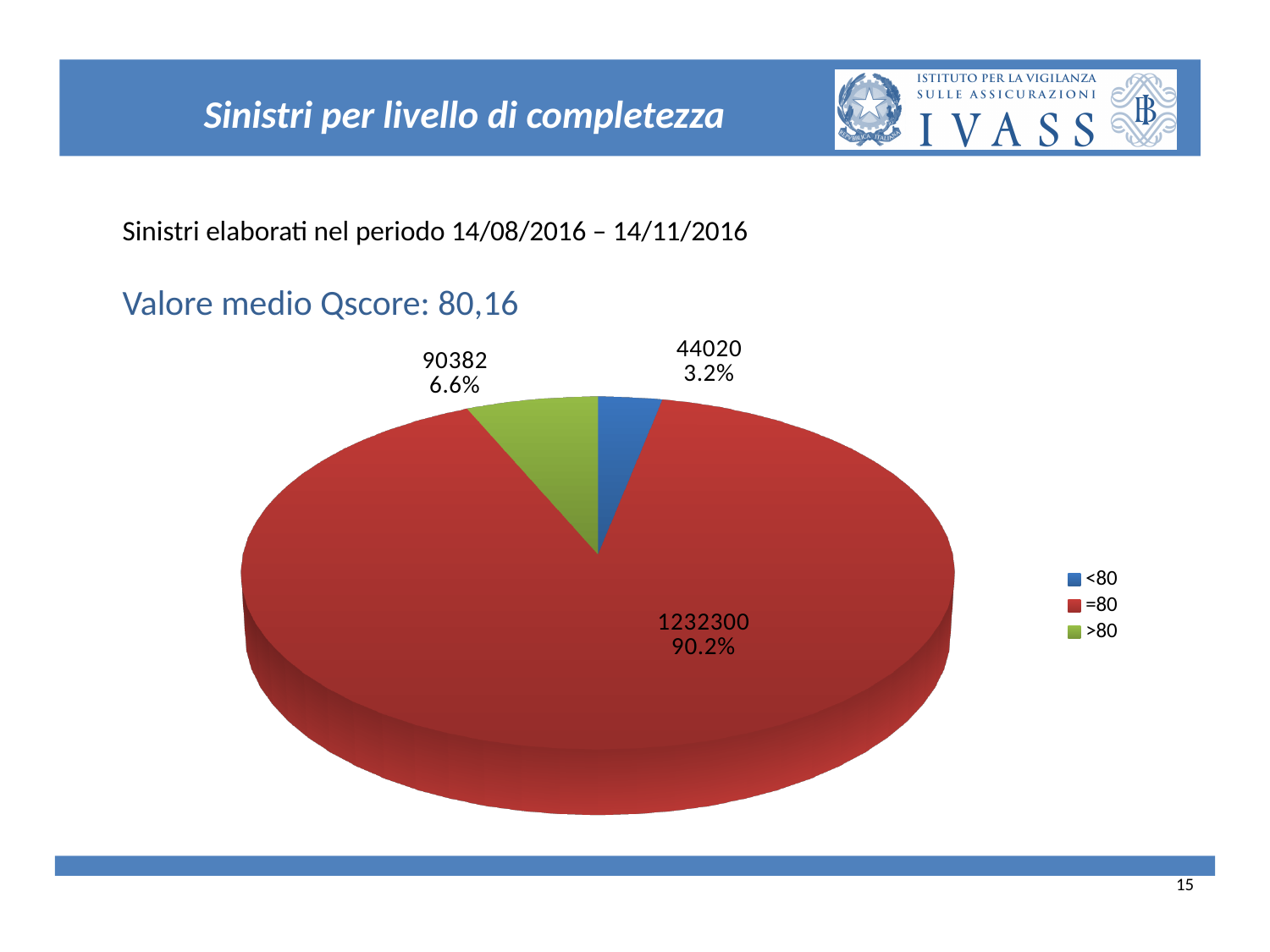
What kind of chart is shown on the slide? pie chart How many slices does the pie chart have? 3 What share of the pie does the =80 slice represent? 90.2% Which colour represents the =80 category in the legend? red What share of the pie does the >80 slice represent? 6.6% Which category has the largest slice? =80 What is the value for the <80 slice? 44020 Which category has the smallest slice? <80 What share of the pie does the <80 slice represent? 3.2% What is the difference between the values for >80 and <80? 46362 What is the value for the =80 slice? 1232300 What is the value for the >80 slice? 90382